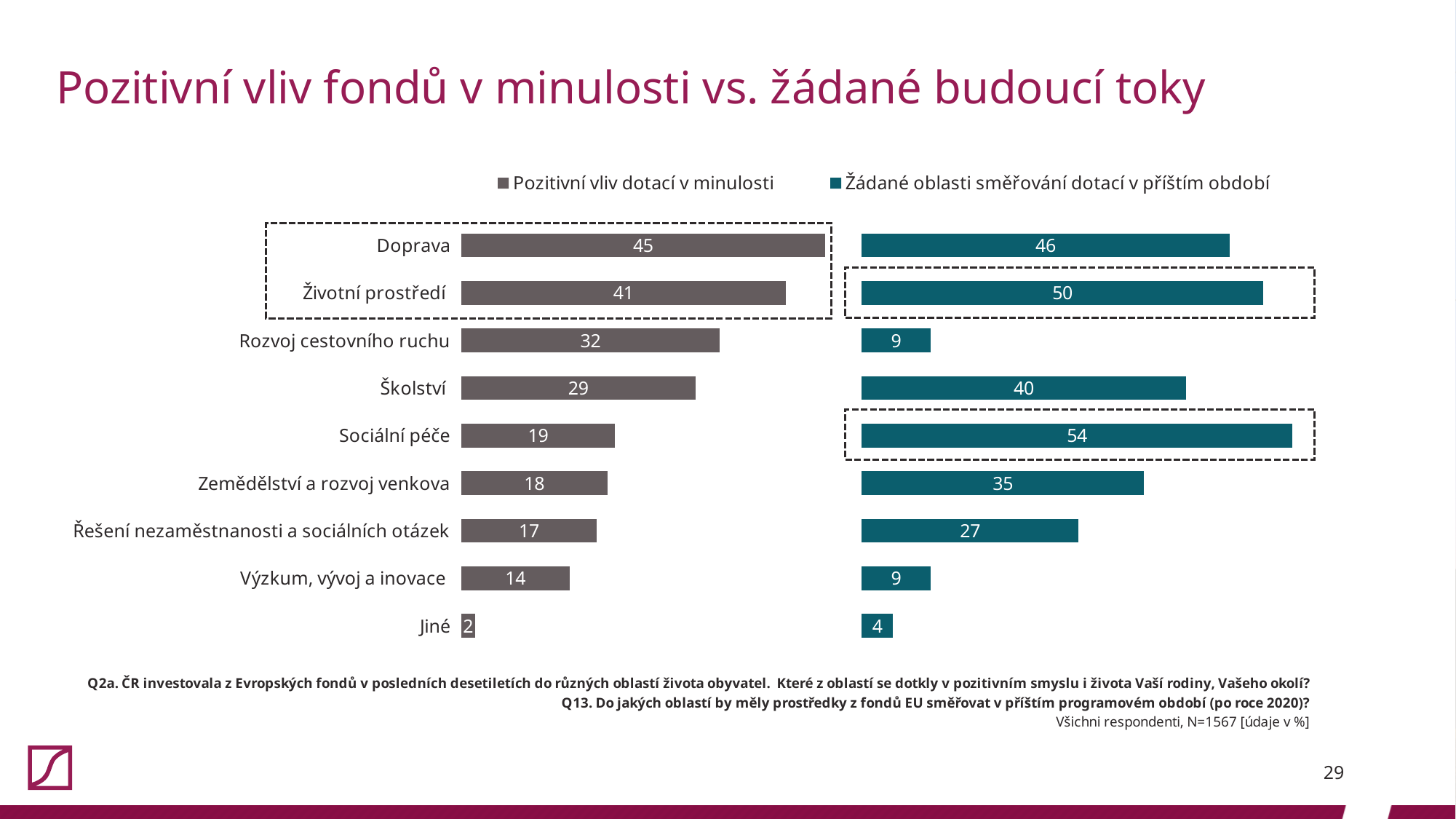
For Rozvoj cestovního ruchu, which series has the larger value? Pozitivní vliv dotací v minulosti Which category has the highest value in the 'Žádané oblasti směřování dotací v příštím období' series? Sociální péče How many categories are shown on the chart? 9 Which category has the lowest value in the 'Pozitivní vliv dotací v minulosti' series? Jiné What is the value for Sociální péče in the 'Žádané oblasti směřování dotací v příštím období' series? 54 What is the title of the slide? Pozitivní vliv fondů v minulosti vs. žádané budoucí toky What is the difference between the two series values for Školství? 11 What is the difference between the 'Žádané oblasti' value for Životní prostředí and its 'Pozitivní vliv' value? 9 What is the value for Doprava in the 'Pozitivní vliv dotací v minulosti' series? 45 How many series does the legend list? 2 What kind of chart is shown on the slide? Bar chart What is the value for Výzkum, vývoj a inovace in the 'Žádané oblasti směřování dotací v příštím období' series? 9